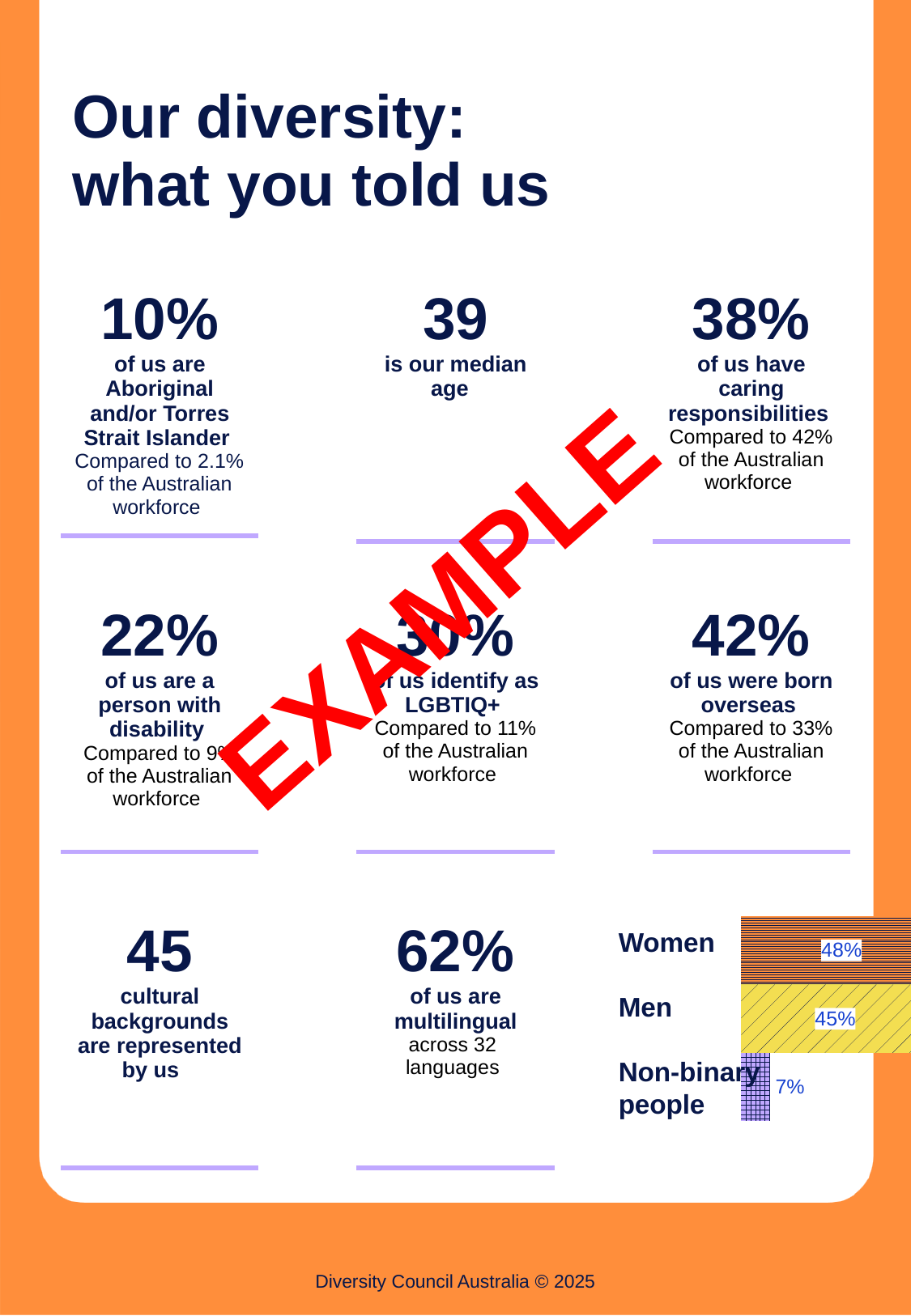
Which category in the bar chart has the lowest value? Non-binary people Which category in the bar chart has the highest value? Women What kind of chart is shown in the bottom right of the slide? bar chart Are the bars in the bar chart horizontal or vertical? horizontal In the bar chart, what is the value for Men? 45% In the bar chart, which is larger: the value for Men or the value for Non-binary people? Men In the bar chart, what is the difference between the values for Men and Non-binary people? 38% In the bar chart, what is the value for Non-binary people? 7% In the bar chart, what is the value for Women? 48% How many categories does the bar chart show? 3 In the bar chart, what is the difference between the values for Women and Men? 3% What is the total of the three values shown in the bar chart? 100%